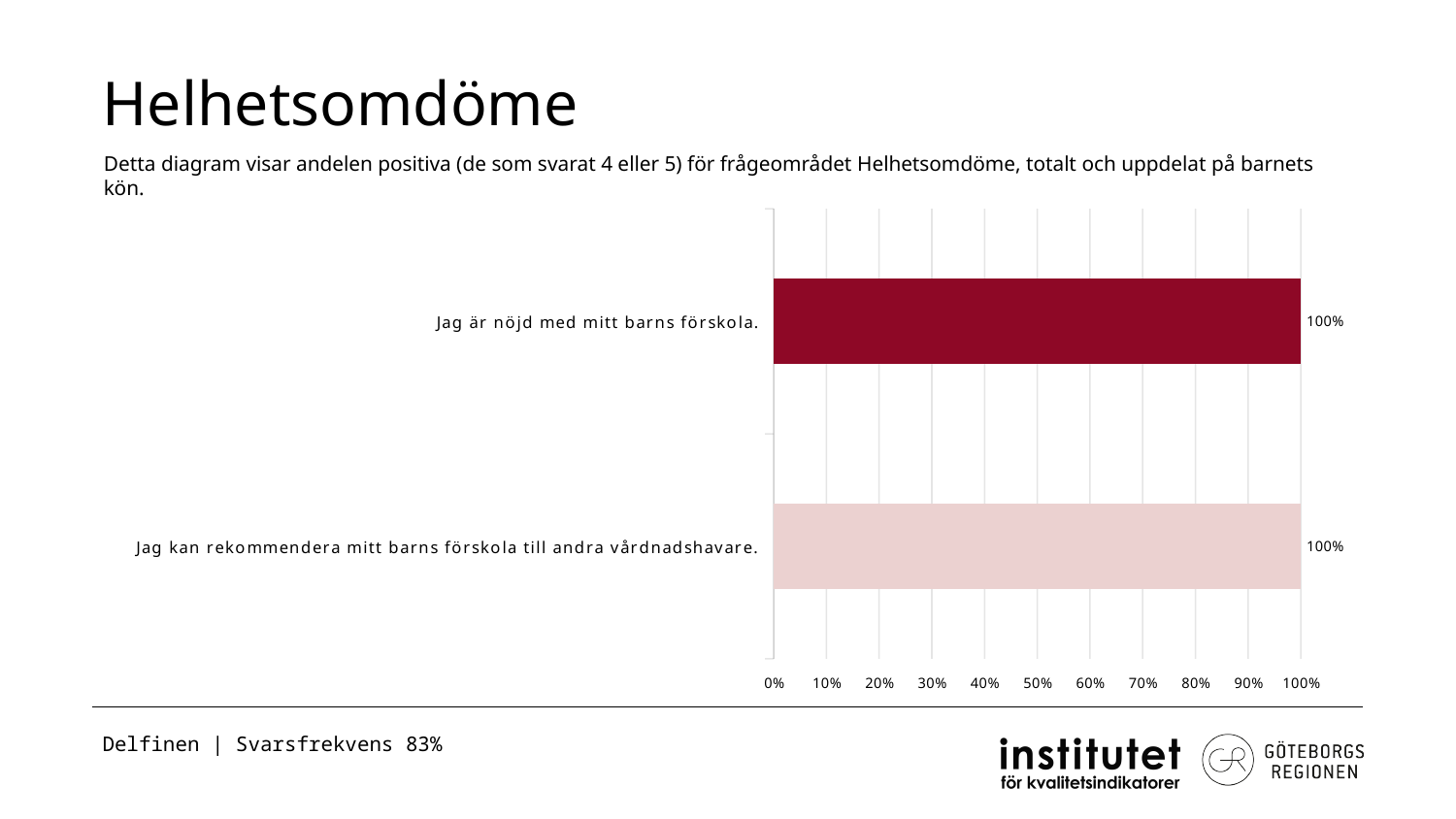
What kind of chart is shown on the slide? Bar chart What is the difference between the values for "Jag är nöjd med mitt barns förskola." and "Jag kan rekommendera mitt barns förskola till andra vårdnadshavare."? 0% What is the value for "Jag kan rekommendera mitt barns förskola till andra vårdnadshavare."? 100% Is the value for "Jag är nöjd med mitt barns förskola." greater or less than 90%? greater What is the value for "Jag är nöjd med mitt barns förskola."? 100% What is the title of the slide containing the chart? Helhetsomdöme Is the value for "Jag kan rekommendera mitt barns förskola till andra vårdnadshavare." greater or less than 50%? greater How many categories (bars) are shown in the chart? 2 What is the highest tick value shown on the x axis of the chart? 100%